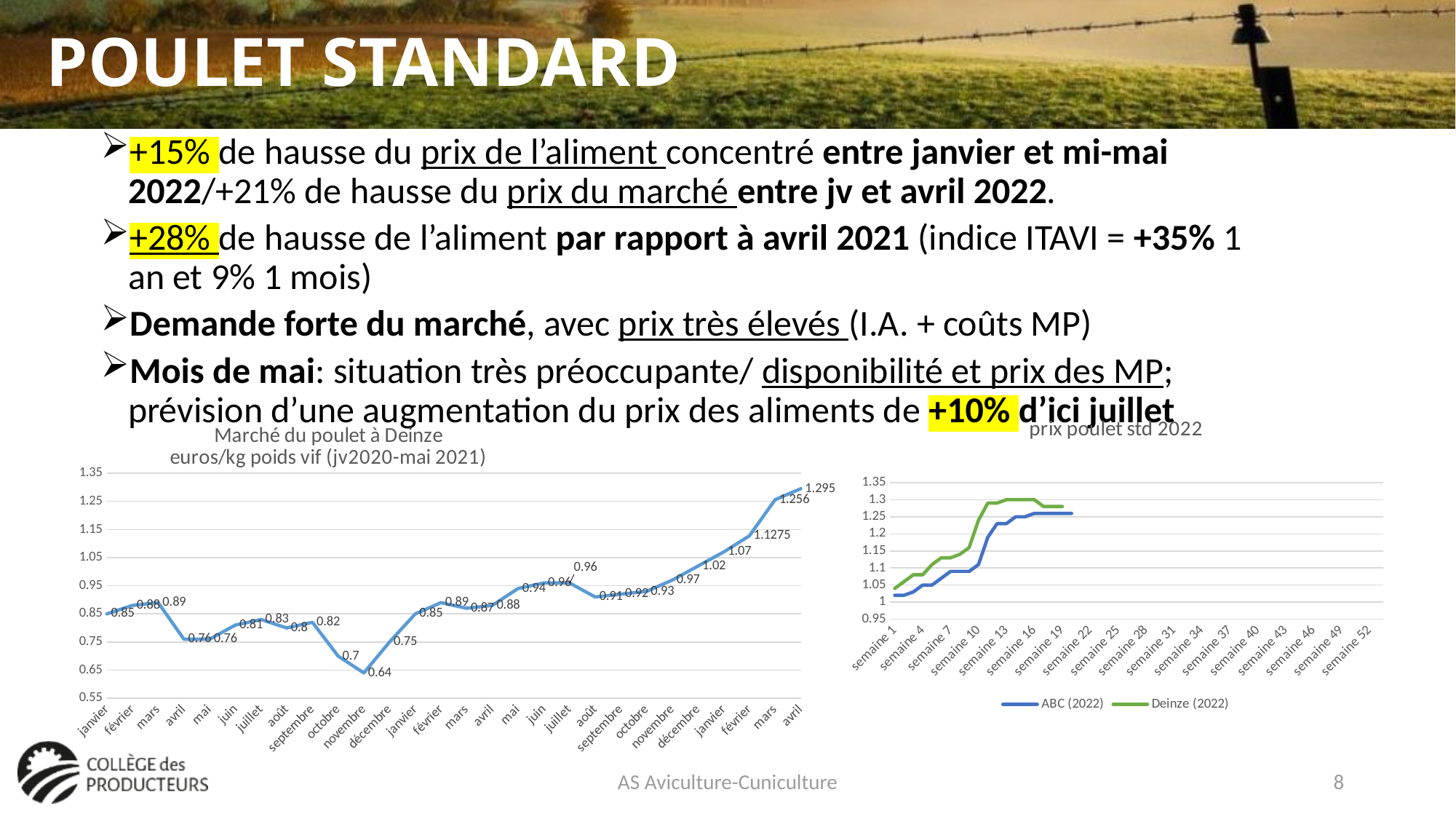
On the chart 'prix poulet std 2022', how many series does the legend list? 2 On the chart 'prix poulet std 2022', which series has the higher value at semaine 10, ABC (2022) or Deinze (2022)? Deinze (2022) On the chart 'prix poulet std 2022', is the value for ABC (2022) at semaine 1 greater or less than 1.05? less On the chart 'prix poulet std 2022', is the value for Deinze (2022) at semaine 13 greater or less than 1.25? greater On the chart 'Marché du poulet à Deinze', which month has the highest value? avril (last point) On the chart 'Marché du poulet à Deinze', which month has the lowest value? novembre (first year) On the chart 'Marché du poulet à Deinze', do the values rise or fall from the second décembre to the final avril? rise On the chart 'Marché du poulet à Deinze', what is the value for the last avril on the x axis? 1.295 On the chart 'Marché du poulet à Deinze', what is the difference between the last avril value (1.295) and the preceding mars value (1.256)? 0.039 On the chart 'Marché du poulet à Deinze', how many data points are plotted? 28 What kind of chart is 'Marché du poulet à Deinze'? line chart On the chart 'Marché du poulet à Deinze', what is the value for the first novembre shown? 0.64